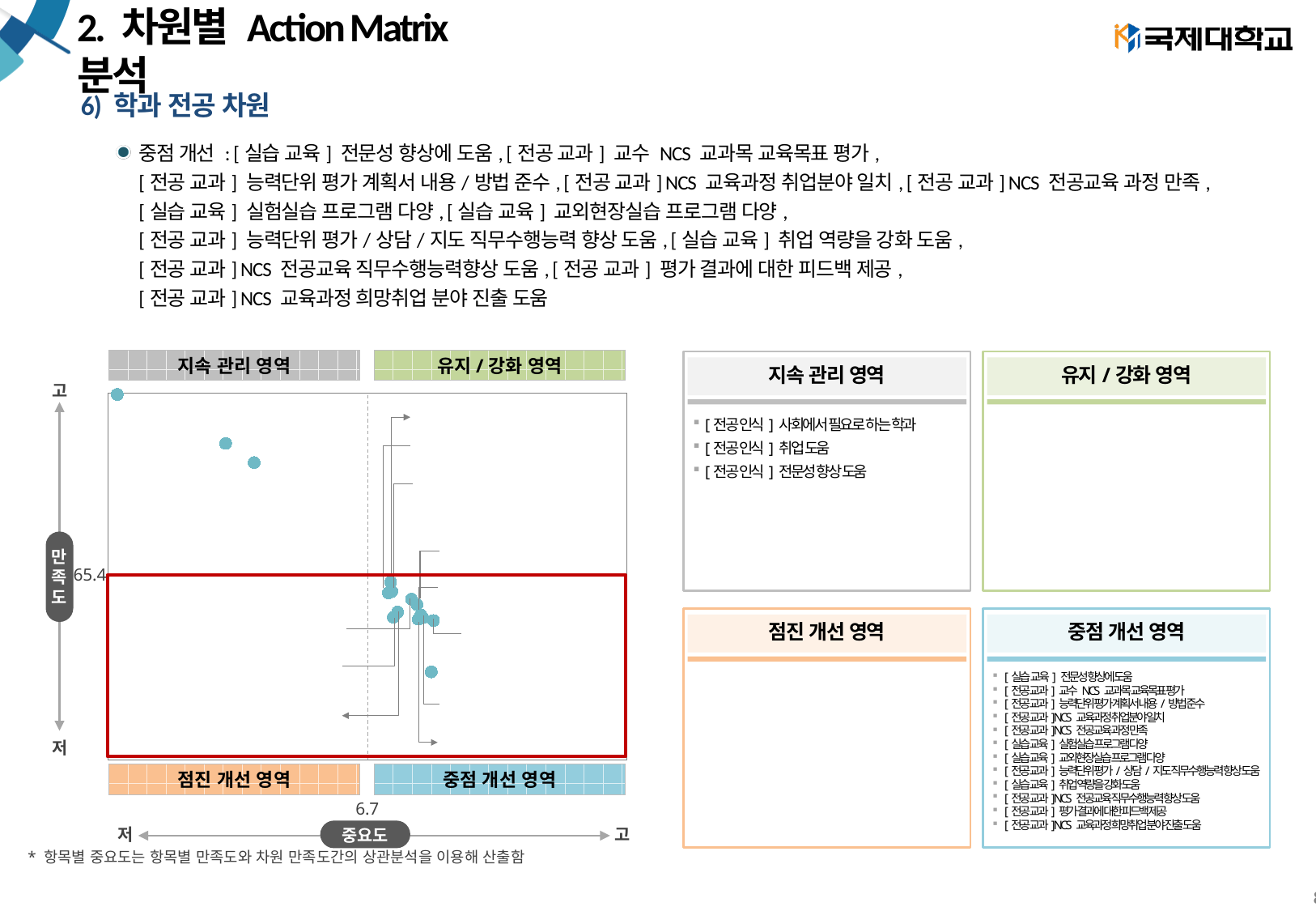
What is the label of the horizontal axis of the action matrix chart? 중요도 How many items are listed in the 지속 관리 영역 box on the right of the slide? 3 Is the 중요도 of the point in the top-left corner of the action matrix greater or less than 6.7? less What is the label of the vertical axis of the action matrix chart? 만족도 Which quadrant of the action matrix contains the most data points? 중점 개선 영역 At what 중요도 value is the vertical dividing line of the action matrix drawn? 6.7 How many quadrant areas are labelled around the action matrix chart? 4 What kind of chart is shown on the left of the slide? scatter chart At what 만족도 value is the horizontal dividing line of the action matrix drawn? 65.4 Does the 유지 / 강화 영역 quadrant of the action matrix contain any data points? No Are the points in the upper-left quadrant of the action matrix above or below the 65.4 만족도 line? above